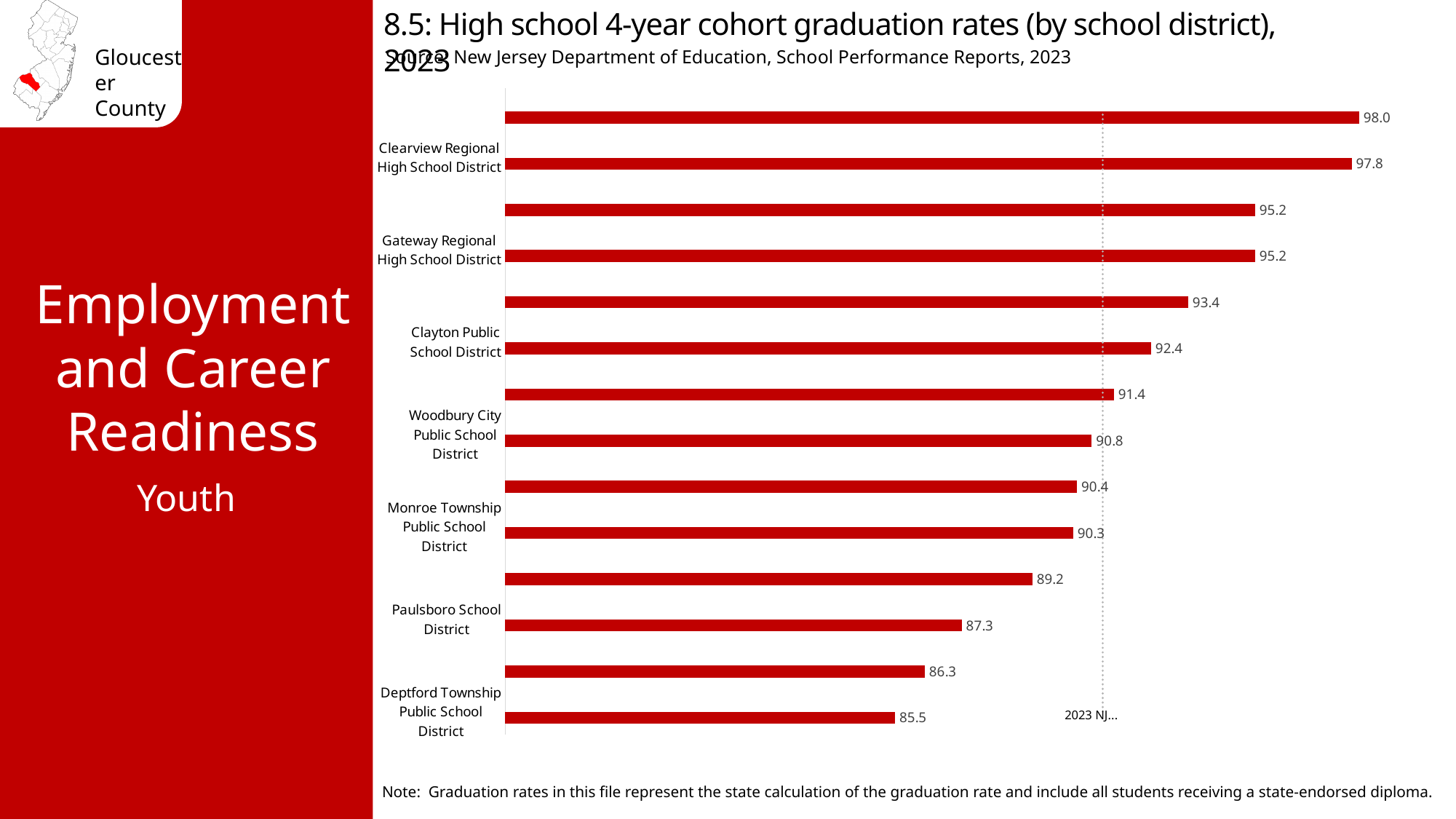
How many bars are plotted on the chart? 14 Which has a higher graduation rate, Clayton Public School District or Monroe Township Public School District? Clayton Public School District What is the source cited for the chart? New Jersey Department of Education, School Performance Reports, 2023 Which labeled district has the lowest graduation rate? Deptford Township Public School District What is the difference between the graduation rates of Clearview Regional High School District and Deptford Township Public School District? 12.3 What kind of chart is shown on the slide? Bar chart What is the highest graduation rate value shown on the chart? 98.0 What is the graduation rate for Woodbury City Public School District? 90.8 What is the graduation rate for Gateway Regional High School District? 95.2 What is the graduation rate for Clayton Public School District? 92.4 What is the graduation rate for Clearview Regional High School District? 97.8 What is the graduation rate for Paulsboro School District? 87.3